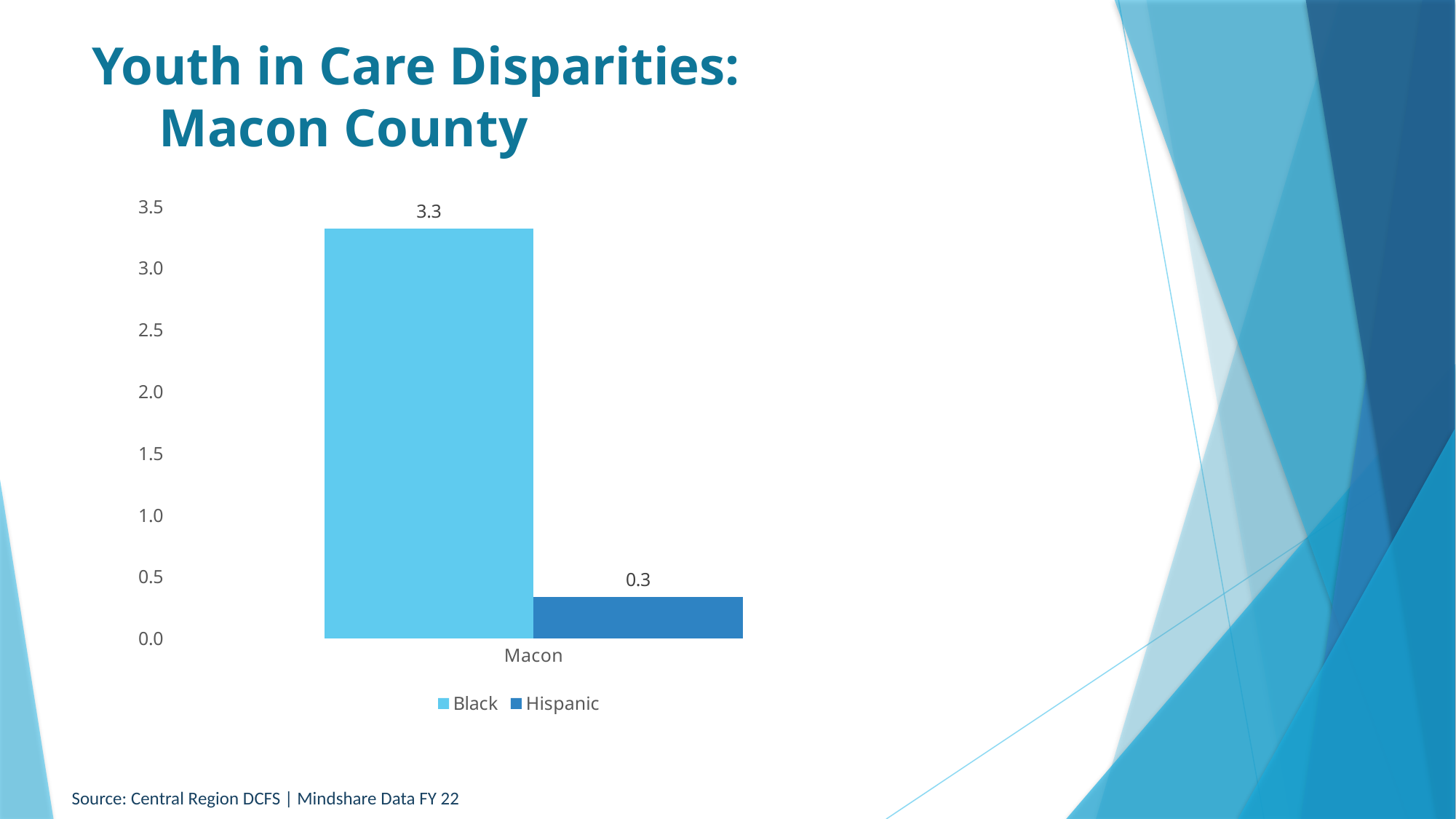
How many categories are shown on the x axis? 1 Which series has the lowest value in the chart? Hispanic What is the highest value shown on the y axis? 3.5 What is the value for Hispanic in Macon? 0.3 Is the value for Black in Macon greater or less than 3.0? greater What is the value for Black in Macon? 3.3 Which series has the higher value for Macon, Black or Hispanic? Black What is the difference between the Black and Hispanic values for Macon? 3.0 What is the title of the slide containing the chart? Youth in Care Disparities: Macon County How many series does the legend list? 2 What kind of chart is shown on the slide? Bar chart Is the value for Hispanic in Macon greater or less than 0.5? less